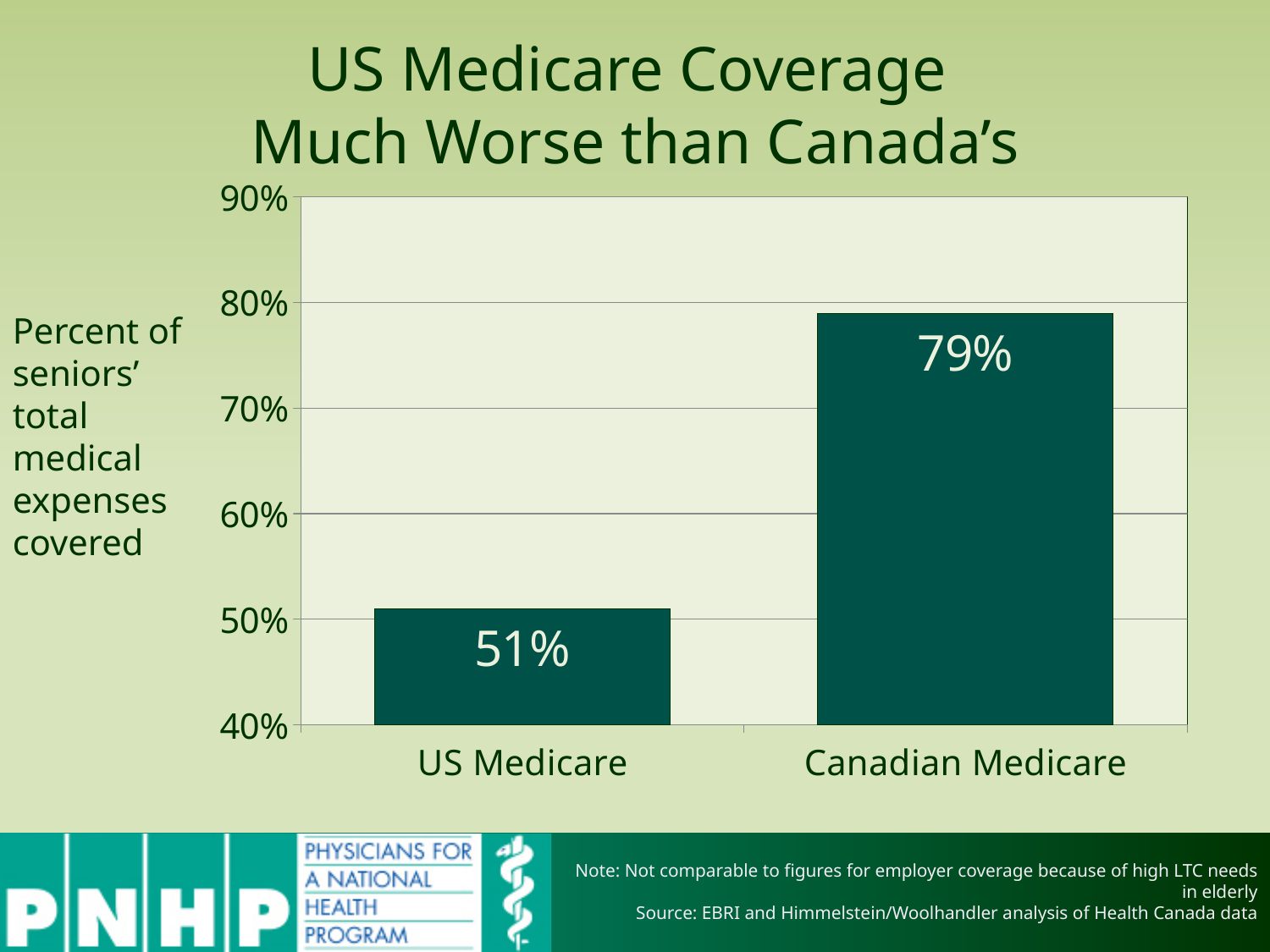
What is the lowest value shown on the vertical axis? 40% How many categories are shown on the chart? 2 Which category has the higher value, US Medicare or Canadian Medicare? Canadian Medicare What percent of seniors' total medical expenses are covered by US Medicare? 51% Is the value for Canadian Medicare greater or less than 70%? greater What is the difference between the Canadian Medicare and US Medicare values? 28 percentage points What is the title of the slide? US Medicare Coverage Much Worse than Canada's What does the vertical axis of the chart measure? Percent of seniors' total medical expenses covered What percent of seniors' total medical expenses are covered by Canadian Medicare? 79% What kind of chart is shown on the slide? Bar chart Is the value for US Medicare greater or less than 60%? less Which category has the lowest value on the chart? US Medicare